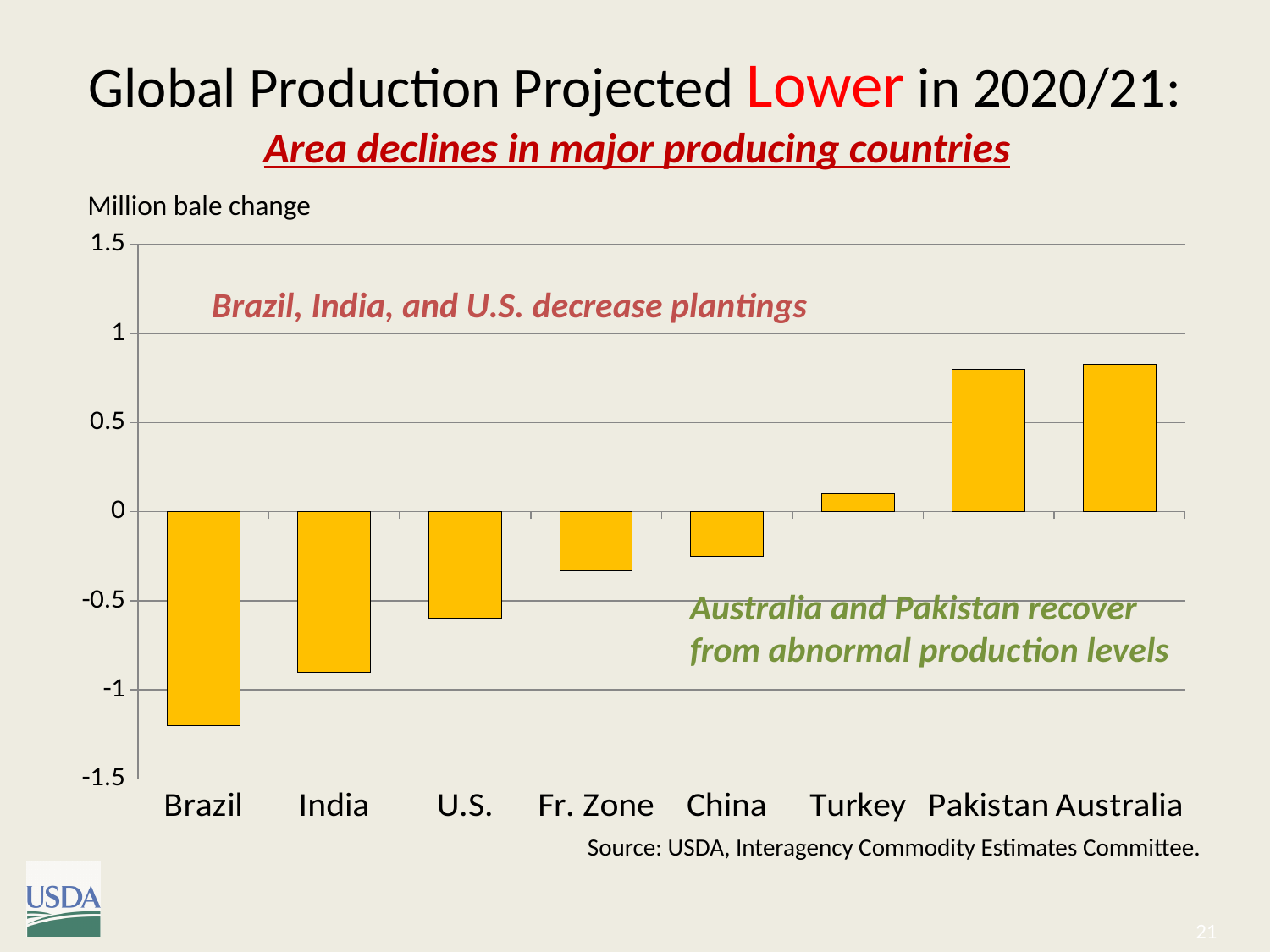
Do the values generally rise or fall moving from Brazil to Australia along the x axis? rise Is the value for China greater or less than -0.5? greater Is the value for Turkey greater or less than 0.5? less What unit label is shown above the chart's vertical axis? Million bale change Which country has the lowest (most negative) million bale change in the chart? Brazil Is the value for Brazil greater or less than -1? less Which has the larger million bale change, India or U.S.? U.S. How many countries or regions are shown on the x axis of the chart? 8 What kind of chart is shown on the slide? bar chart